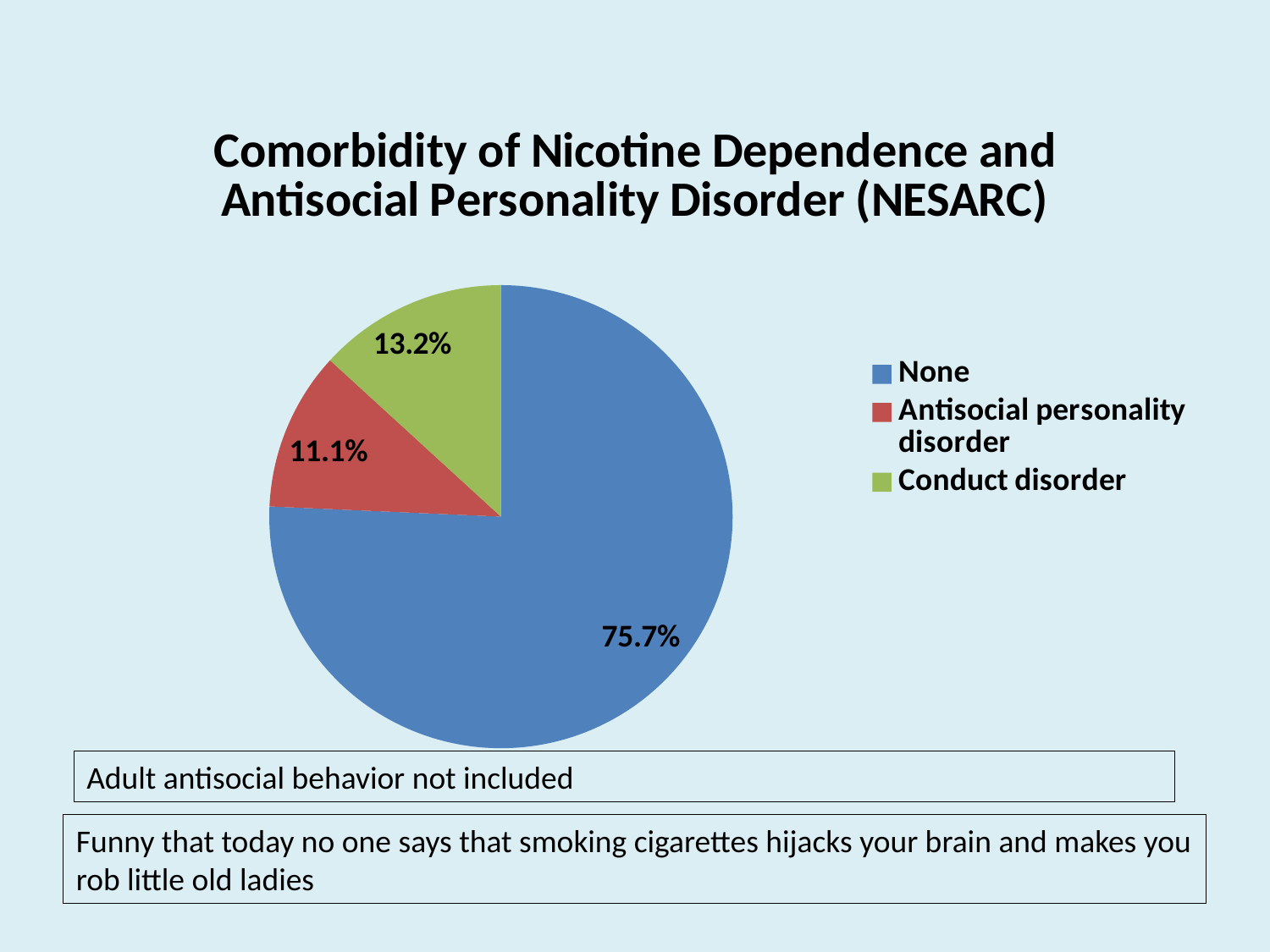
Which is larger, the slice for Conduct disorder or the slice for Antisocial personality disorder? Conduct disorder Which category has the smallest slice? Antisocial personality disorder What is the value for None? 75.7% How many slices does the pie chart have? 3 What is the title of the chart? Comorbidity of Nicotine Dependence and Antisocial Personality Disorder (NESARC) What kind of chart is shown on the slide? pie chart What is the value for Antisocial personality disorder? 11.1% What is the difference between the values for Conduct disorder and Antisocial personality disorder? 2.1% What colour is the slice for Conduct disorder? green Which category has the largest slice? None What is the difference between the values for None and Conduct disorder? 62.5% What is the value for Conduct disorder? 13.2%